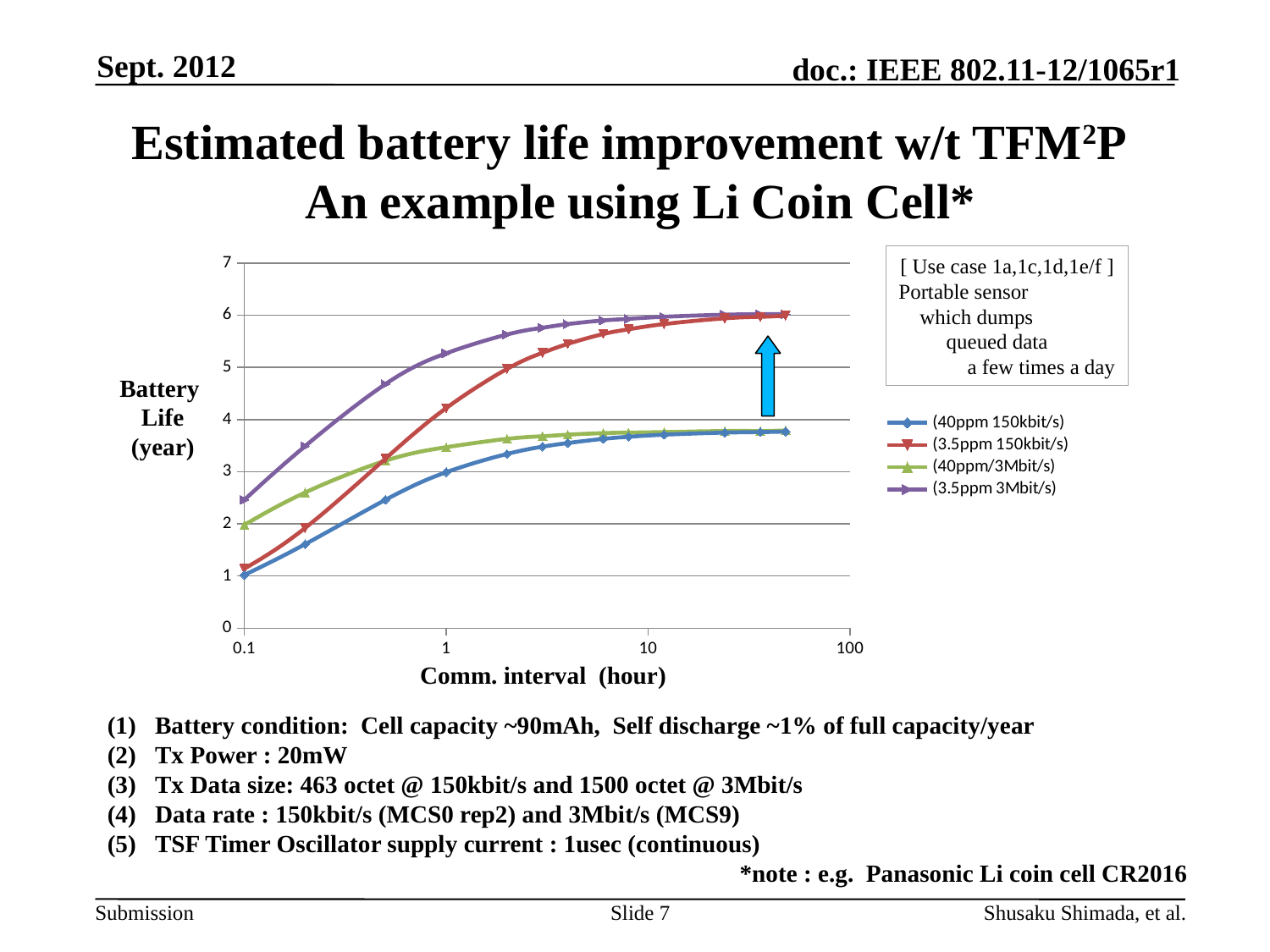
Is the battery life for (40ppm/3Mbit/s) at a communication interval of 10 hours greater or less than 4 years? less What is the label of the y axis? Battery Life (year) Is the battery life for (3.5ppm 3Mbit/s) at a communication interval of 0.1 hour greater or less than 2 years? greater Is the battery life for (3.5ppm 3Mbit/s) at a communication interval of 1 hour greater or less than 5 years? greater What is the label of the x axis? Comm. interval (hour) Which series has the lowest battery life at a communication interval of 0.1 hour? (40ppm 150kbit/s) What kind of chart is shown on the slide? line chart Which series has the highest battery life at a communication interval of 0.1 hour? (3.5ppm 3Mbit/s) At a communication interval of 10 hours, which series has the larger battery life: (3.5ppm 150kbit/s) or (40ppm/3Mbit/s)? (3.5ppm 150kbit/s) How many series does the legend list? 4 Do the battery life values rise or fall as the communication interval increases? rise